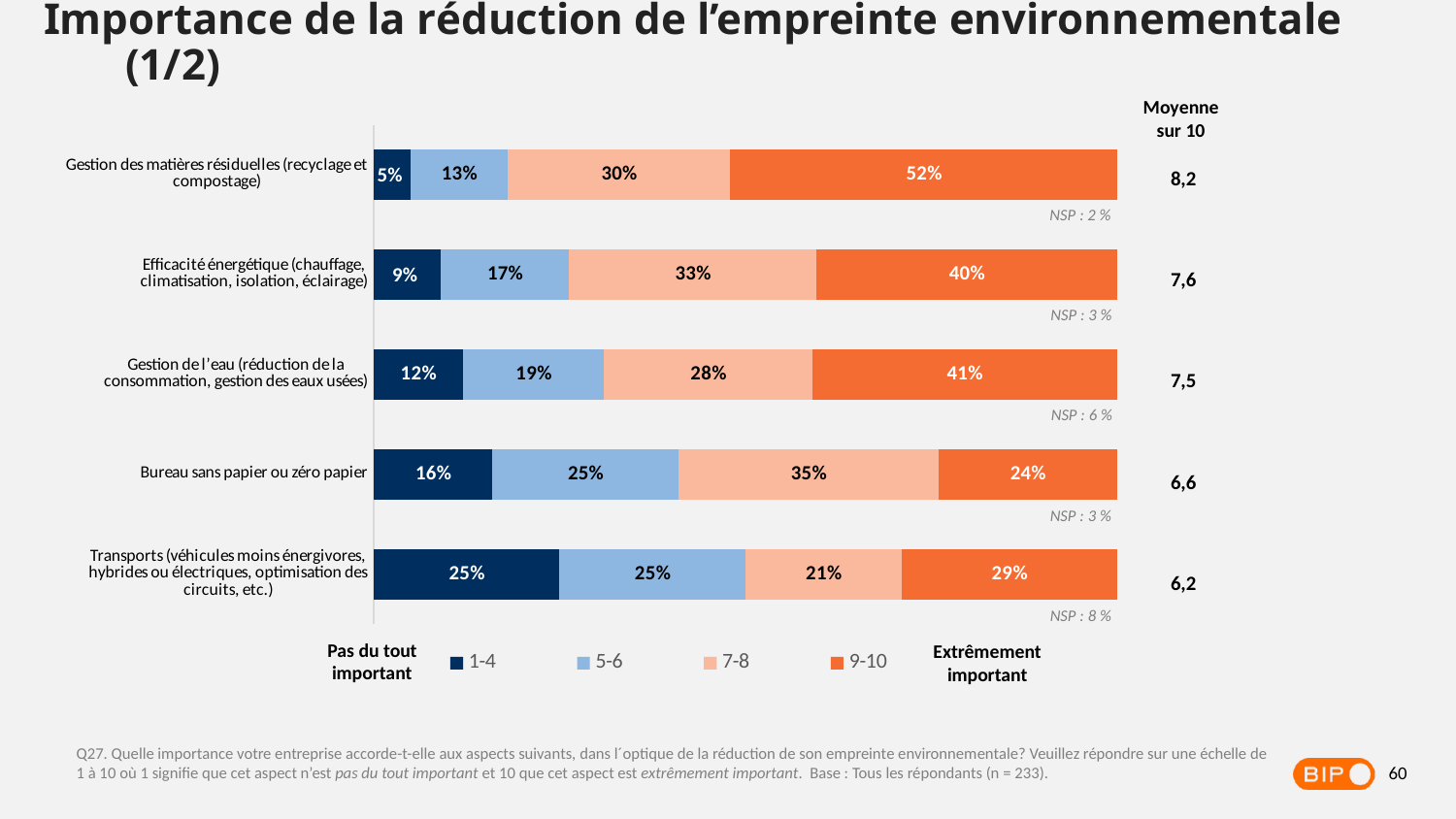
Which category has the largest share of 1-4 ratings? Transports (véhicules moins énergivores, hybrides ou électriques, optimisation des circuits, etc.) What percentage of respondents rated 'Gestion des matières résiduelles (recyclage et compostage)' as 9-10? 52% What is the 'Moyenne sur 10' for 'Transports (véhicules moins énergivores, hybrides ou électriques, optimisation des circuits, etc.)'? 6,2 What is the NSP value shown for 'Gestion de l'eau (réduction de la consommation, gestion des eaux usées)'? 6 % What kind of chart is shown on the slide? Stacked bar chart Which category has the lowest share of 9-10 ratings? Bureau sans papier ou zéro papier Which category has the highest 'Moyenne sur 10'? Gestion des matières résiduelles (recyclage et compostage) What percentage of respondents rated 'Bureau sans papier ou zéro papier' as 7-8? 35% How many series does the legend list? 4 How many categories are shown in the chart? 5 Which is larger: the 5-6 share for 'Gestion de l'eau' or the 5-6 share for 'Efficacité énergétique'? Gestion de l'eau What is the difference between the 9-10 share for 'Gestion des matières résiduelles' and the 9-10 share for 'Efficacité énergétique'? 12%